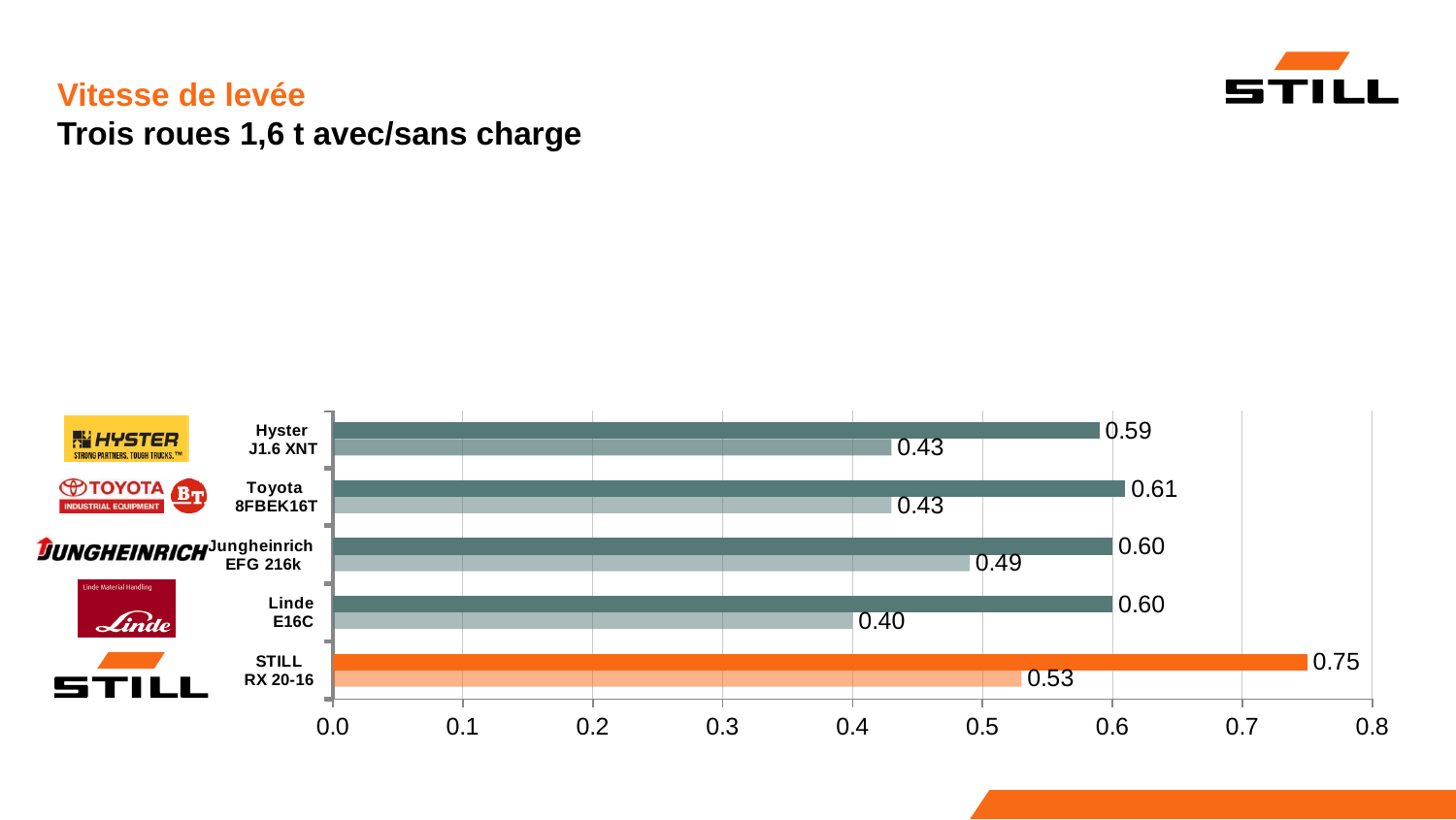
What is the difference between the lower bar values of Jungheinrich EFG 216k and Hyster J1.6 XNT? 0.06 What is the value of the lower (lighter) bar for Jungheinrich EFG 216k? 0.49 What is the orange title text at the top of the slide? Vitesse de levée How many trucks (categories) are shown in the chart? 5 Which truck has the lowest value on its lower (lighter) bar? Linde E16C What kind of chart is shown on the slide? bar chart Which has the larger upper (darker) bar value, Toyota 8FBEK16T or Hyster J1.6 XNT? Toyota 8FBEK16T What is the value of the upper (darker) bar for Linde E16C? 0.60 Which truck has the highest value on its upper (darker) bar? STILL RX 20-16 Is the upper bar value for STILL RX 20-16 greater or less than 0.7? greater What is the difference between the upper and lower bar values for STILL RX 20-16? 0.22 What is the value of the upper (darker) bar for STILL RX 20-16? 0.75